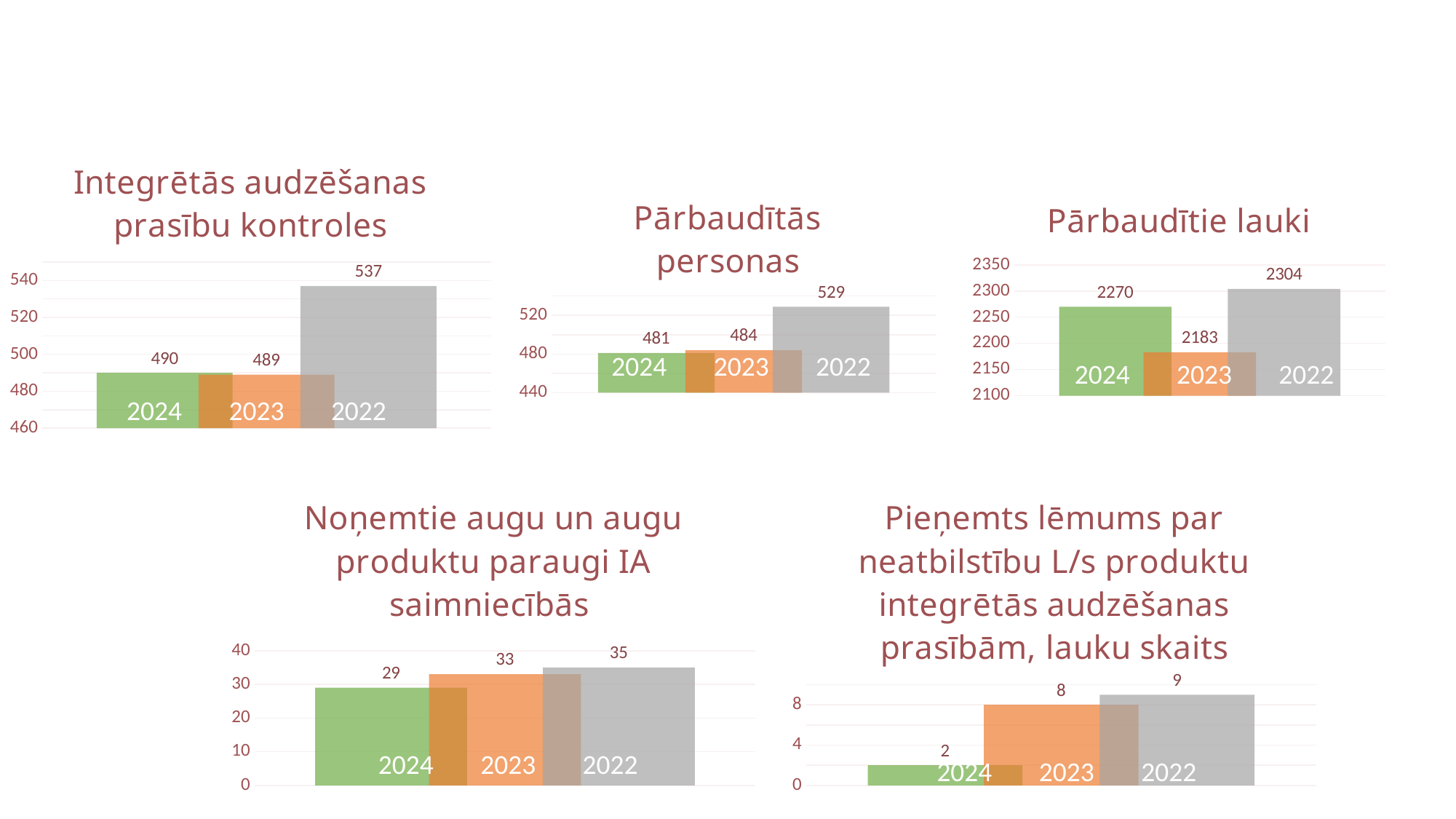
In the chart titled "Pārbaudītie lauki", what is the difference between the 2022 and 2023 values? 121 In the chart titled "Noņemtie augu un augu produktu paraugi IA saimniecībās", what is the value for 2024? 29 In the chart titled "Pārbaudītie lauki", what is the value for 2024? 2270 What type of chart is the chart titled "Pārbaudītās personas"? bar chart In the chart titled "Pārbaudītās personas", which year has the highest value? 2022 In the chart titled "Integrētās audzēšanas prasību kontroles", what is the value for 2022? 537 In the chart titled "Pārbaudītās personas", what is the value for 2023? 484 In the chart titled "Integrētās audzēšanas prasību kontroles", what is the difference between the 2022 and 2024 values? 47 In the chart titled "Noņemtie augu un augu produktu paraugi IA saimniecībās", is the value for 2023 larger or smaller than the value for 2022? smaller In the chart titled "Pārbaudītie lauki", which year has the lowest value? 2023 How many bars are shown in the chart titled "Pieņemts lēmums par neatbilstību L/s produktu integrētās audzēšanas prasībām, lauku skaits"? 3 In the chart titled "Pieņemts lēmums par neatbilstību L/s produktu integrētās audzēšanas prasībām, lauku skaits", what is the value for 2024? 2